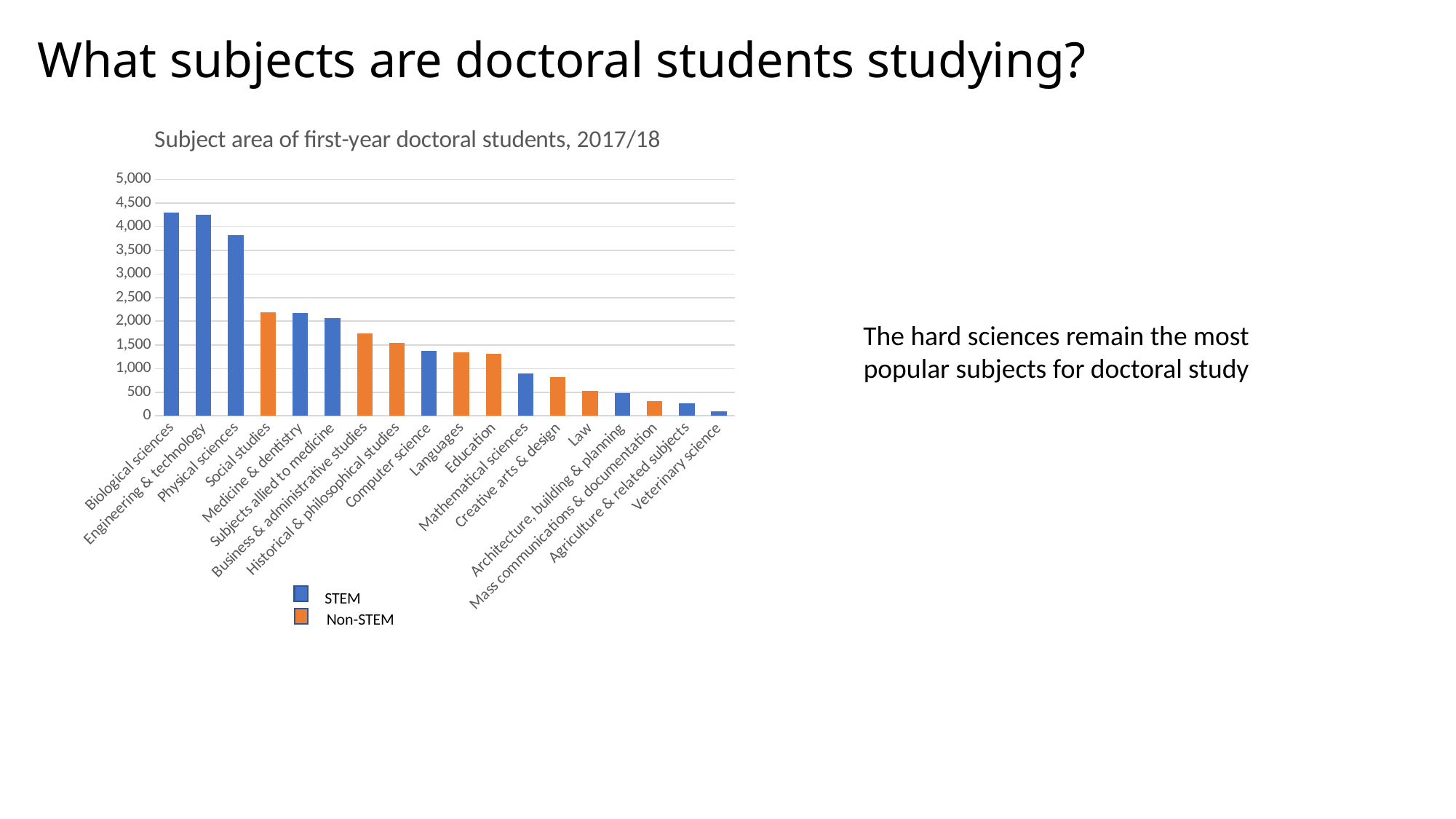
Is the value for Social studies greater or less than 2,000? greater How many series does the chart legend list? 2 Which subject area has the lowest number of first-year doctoral students? Veterinary science Do the values rise or fall moving from left to right along the x axis? fall Is the value for Veterinary science greater or less than 500? less Is the value for Computer science greater or less than 1,500? less Which has more first-year doctoral students, Physical sciences or Social studies? Physical sciences What kind of chart is shown on the slide? bar chart How many subject areas are shown on the x axis of the chart? 18 What is the title of the chart? Subject area of first-year doctoral students, 2017/18